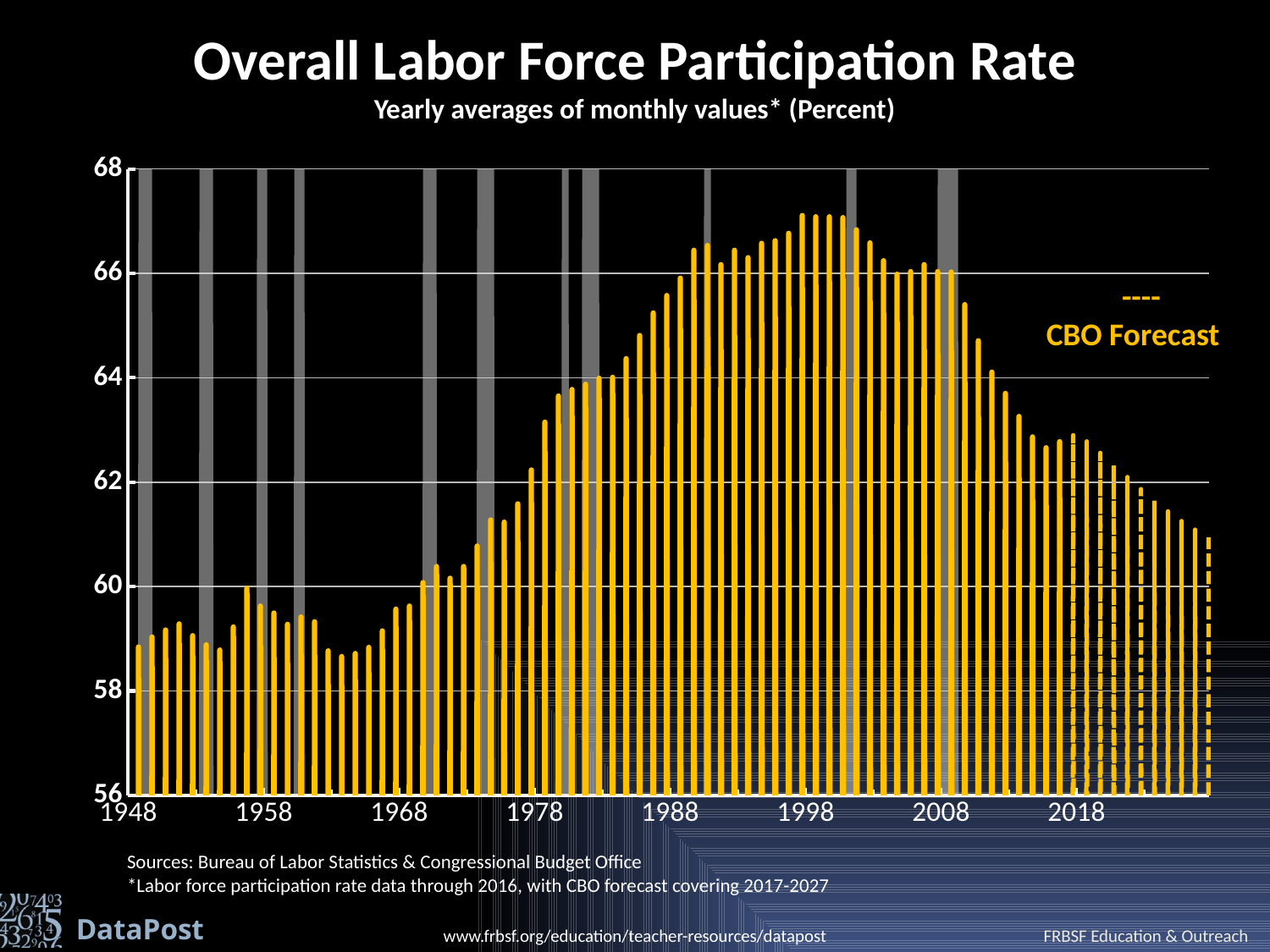
Do the values generally rise or fall between 1968 and 1998? rise Is the value for 1998 greater or less than 66? greater Is the value for 2018 greater or less than 64? less Which year has the larger value, 2008 or 2018? 2008 Is the value for 1948 greater or less than 60? less What kind of chart is shown on the slide? Bar chart Which year has the larger value, 1948 or 1998? 1998 Do the values generally rise or fall between 2008 and 2018? fall What do the dashed bars at the right end of the chart represent? CBO Forecast What is the title of the chart? Overall Labor Force Participation Rate